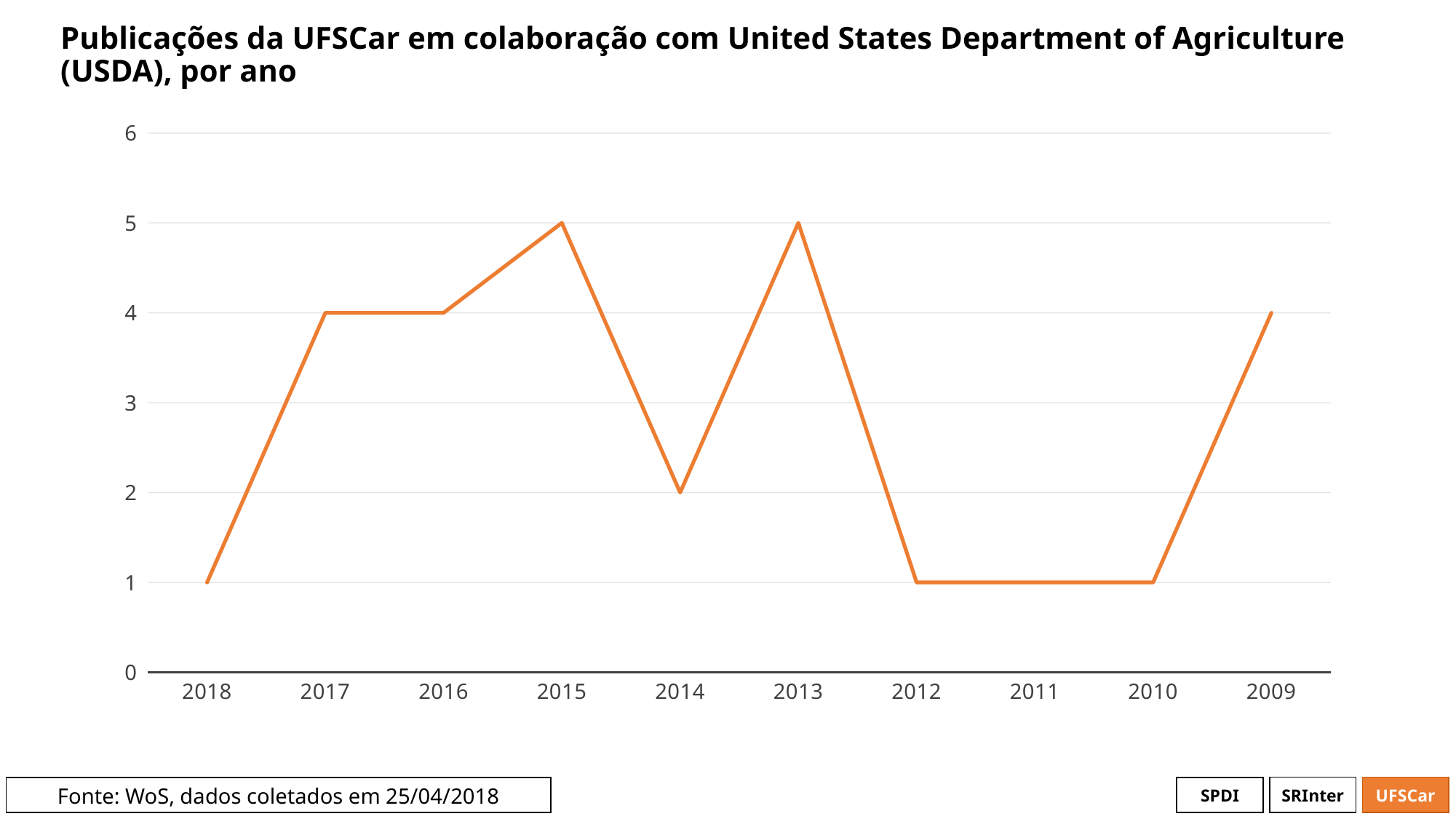
What is the value for 2015? 5 What is the value for 2009? 4 What is the highest value plotted on the chart? 5 What is the difference between the values for 2015 and 2014? 3 Which is larger, the value for 2017 or the value for 2014? 2017 What is the value for 2017? 4 What kind of chart is shown on the slide? line chart What is the value for 2014? 2 What is the value for 2018? 1 Do the values rise, fall or stay flat from 2012 to 2010? stay flat How many years are plotted on the x axis? 10 What is the lowest value plotted on the chart? 1